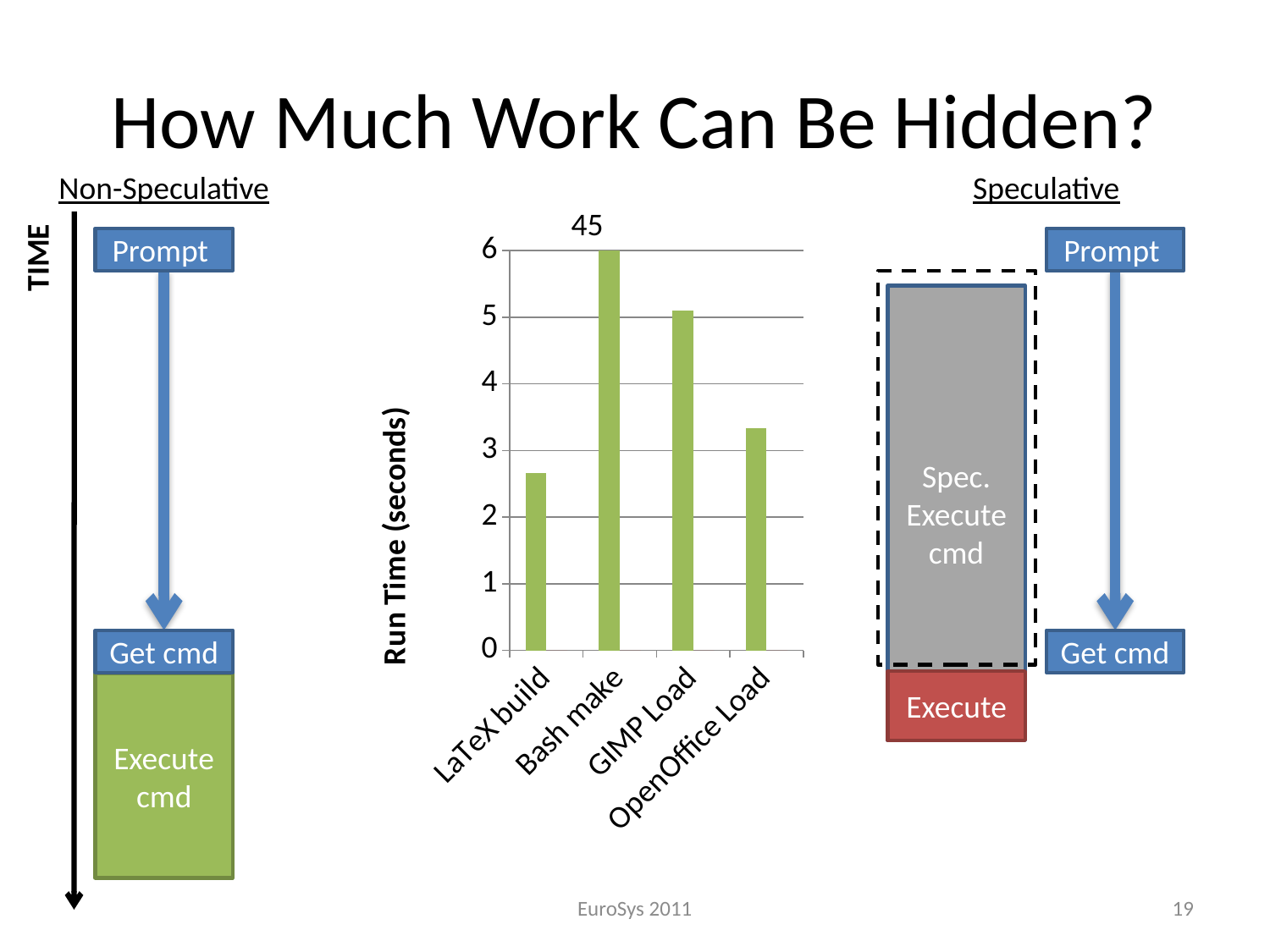
Is the run time for GIMP Load greater or less than 4 seconds? greater Which category has the lowest run time? LaTeX build Is the run time for OpenOffice Load greater or less than 3 seconds? greater Is the run time for OpenOffice Load greater or less than 4 seconds? less What kind of chart is shown on the slide? bar chart What is the run time shown for Bash make? 45 Which has a longer run time, LaTeX build or OpenOffice Load? OpenOffice Load Which has a longer run time, GIMP Load or OpenOffice Load? GIMP Load How many categories are plotted in the chart? 4 Which category has the highest run time? Bash make What is the label of the vertical axis of the chart? Run Time (seconds)